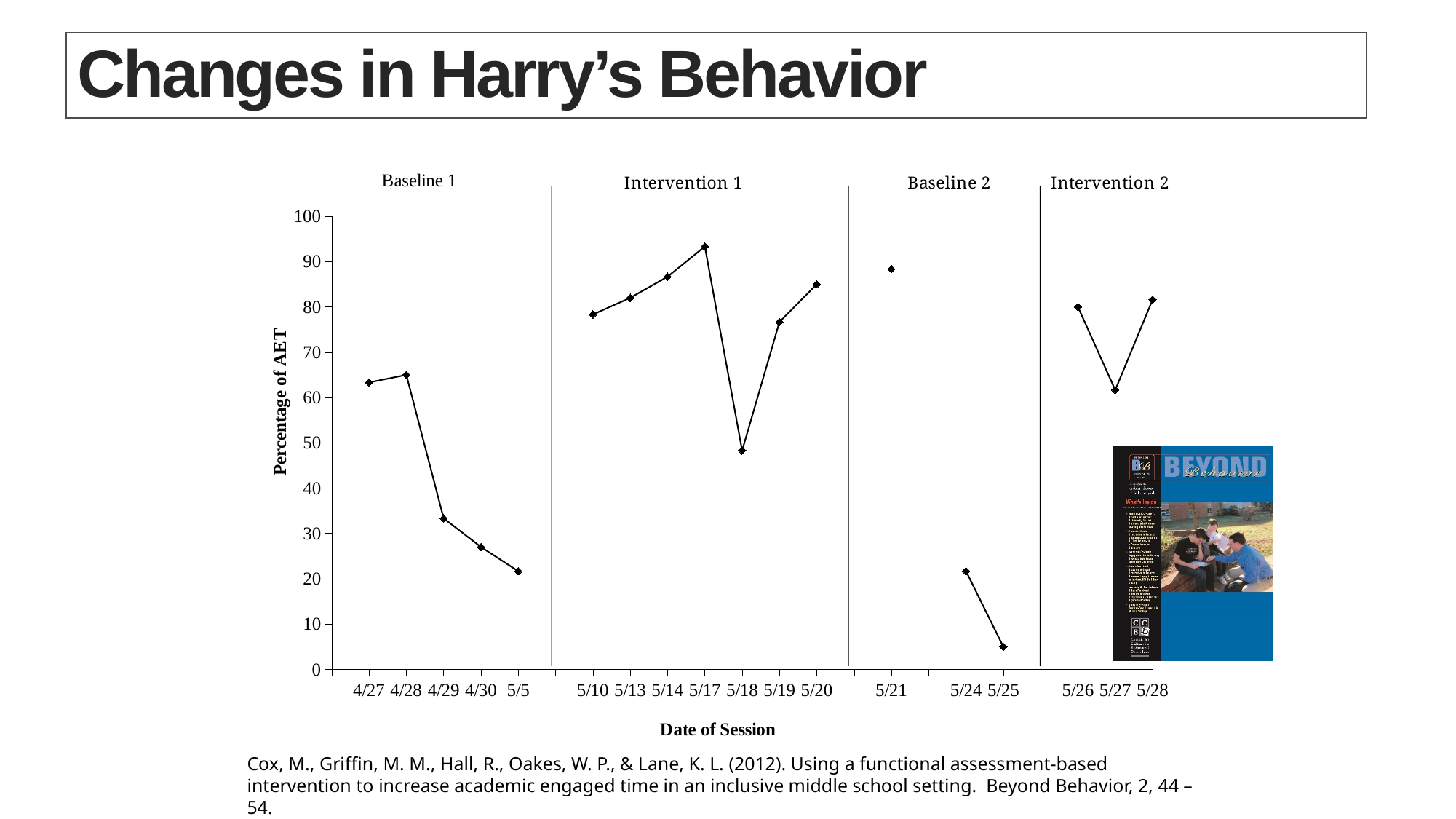
Is the value for 5/18 greater or less than 50? less On which session date is the percentage of AET lowest? 5/25 What kind of chart is shown on the slide? line chart Which has the higher percentage of AET, 5/26 or 5/27? 5/26 Which has the higher percentage of AET, 4/28 or 4/29? 4/28 Do the values rise or fall across the Baseline 1 phase from 4/27 to 5/5? fall Is the value for 5/10 greater or less than 70? greater What is the label on the y axis? Percentage of AET How many session dates are plotted along the x axis? 18 Is the value for 5/25 greater or less than 10? less On which session date is the percentage of AET highest? 5/17